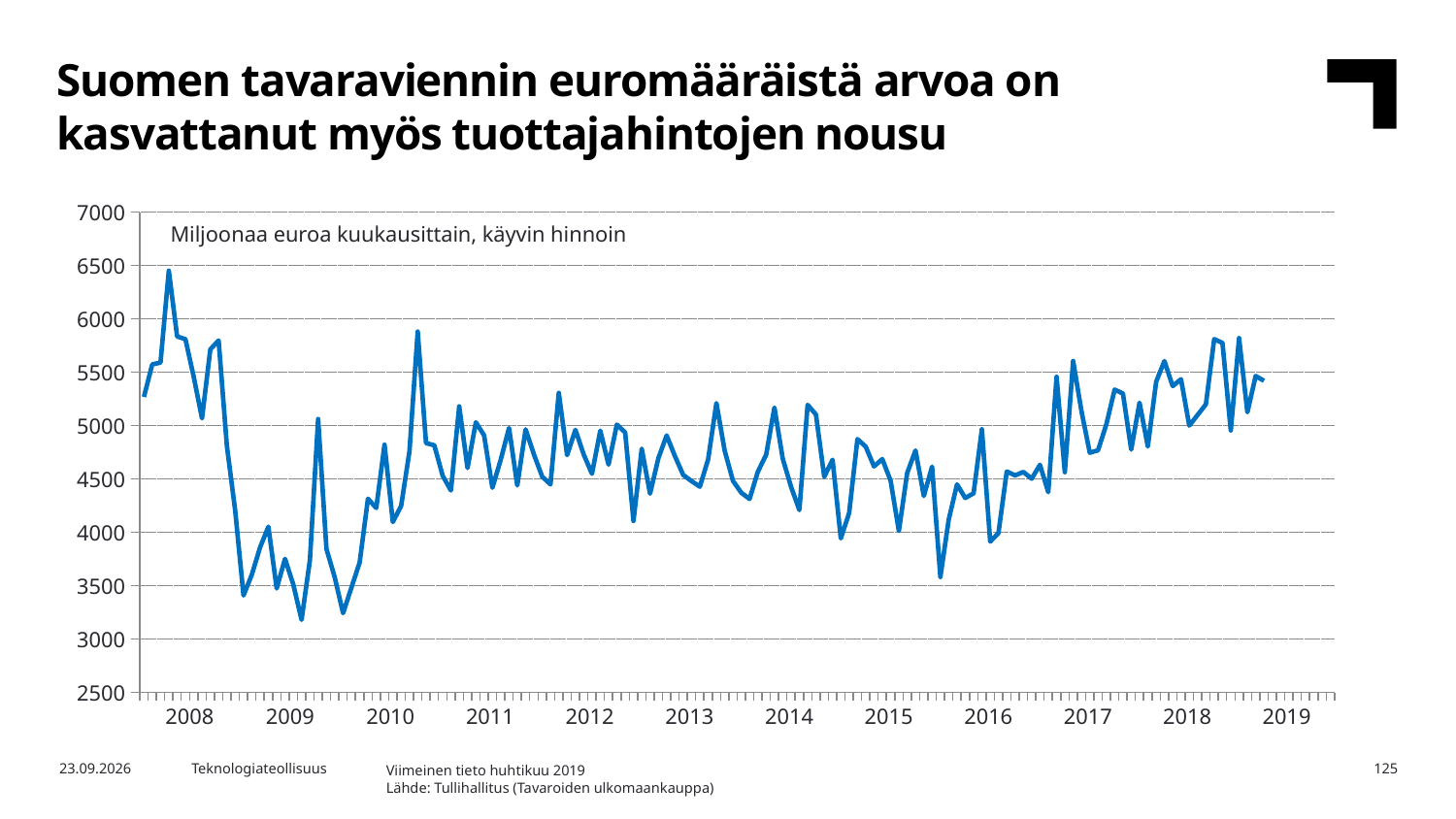
What is the highest value shown on the vertical axis? 7000 Which is higher: the peak in 2008 or the peak in 2018? the peak in 2008 In which year does the line reach its highest peak? 2008 Do the values generally rise or fall from 2016 to 2019? rise Is the peak value in 2008 greater or less than 6000? greater What unit does the chart's subtitle say the values are in? Miljoonaa euroa kuukausittain, käyvin hinnoin Is the lowest value in 2009 greater or less than 3500? less In which year does the line reach its lowest point? 2009 What kind of chart is shown on the slide? line chart How many year labels are shown on the horizontal axis? 12 How many lines are plotted on the chart? 1